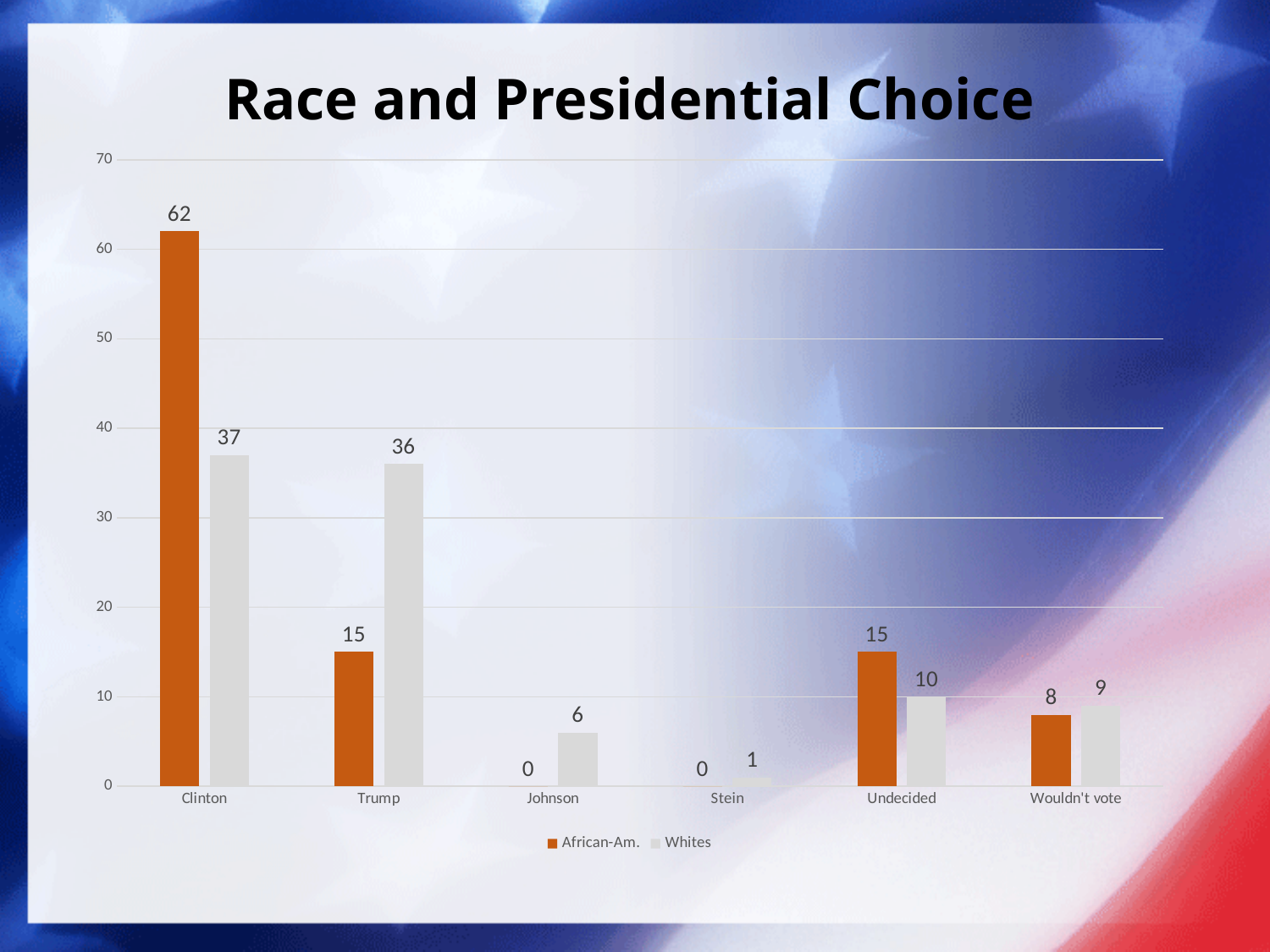
How many series does the legend list? 2 What kind of chart is shown on the slide? Bar chart What is the difference between the African-Am. and Whites values for Clinton? 25 What is the value for African-Am. for Clinton? 62 What is the title of the chart? Race and Presidential Choice What is the value for Whites for Johnson? 6 Which category has the highest value for African-Am.? Clinton Which is larger for Trump: the African-Am. value or the Whites value? Whites Which category has the lowest value for Whites? Stein How many categories are shown on the x axis? 6 What is the value for African-Am. for Undecided? 15 What is the value for Whites for Trump? 36